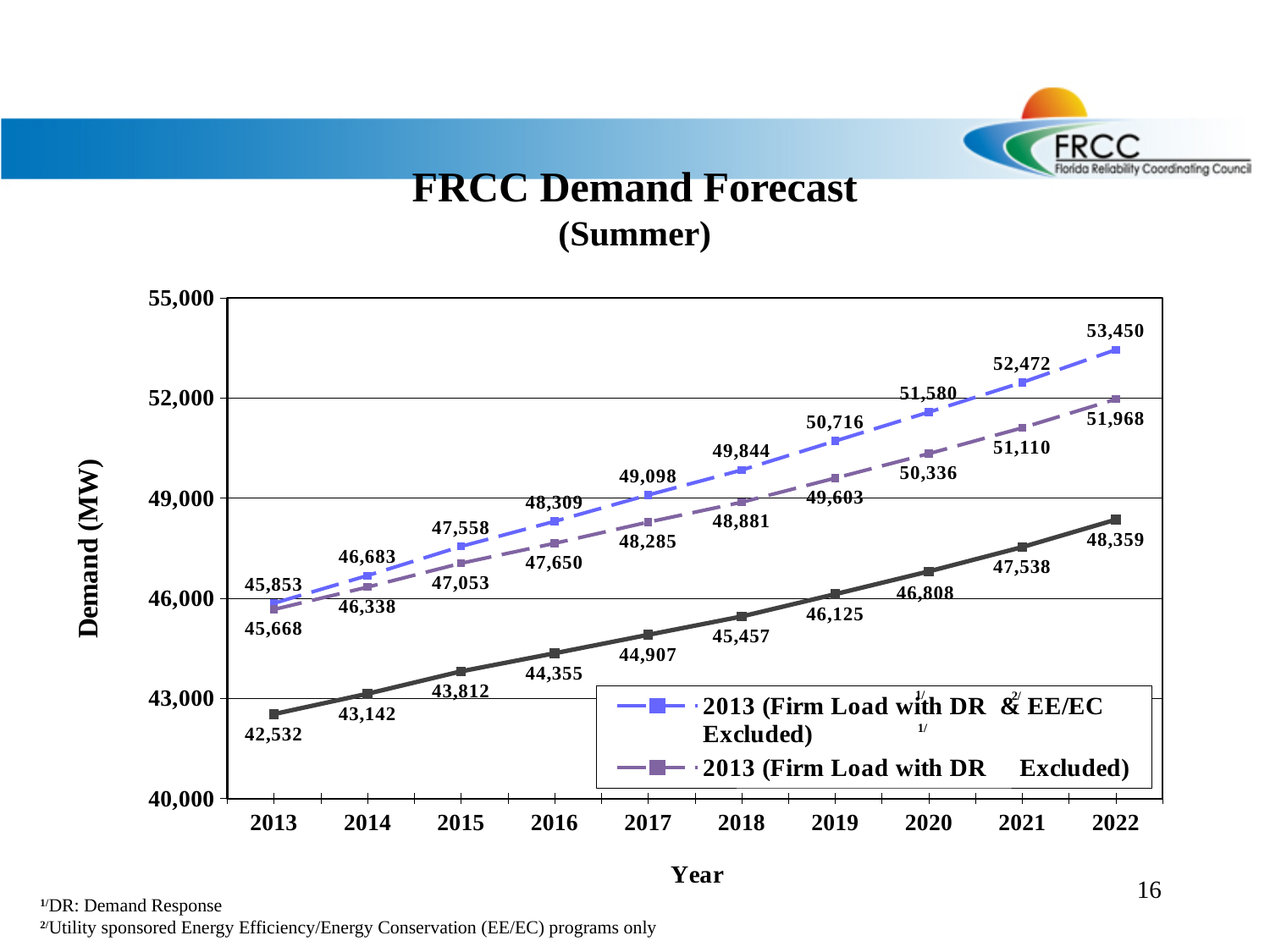
In 2018, which is larger: the '2013 (Firm Load with DR & EE/EC Excluded)' value or the '2013 (Firm Load with DR Excluded)' value? 2013 (Firm Load with DR & EE/EC Excluded) What is the difference between the two dashed series' values in 2022 (53,450 and 51,968)? 1,482 In which year is the solid black line at its lowest value? 2013 In which year does the '2013 (Firm Load with DR & EE/EC Excluded)' series reach its highest value? 2022 What is the title of the chart? FRCC Demand Forecast (Summer) Do the values of the '2013 (Firm Load with DR Excluded)' series rise or fall from 2013 to 2022? Rise How many years are plotted on the x axis? 10 What is the 2013 value for the '2013 (Firm Load with DR Excluded)' series? 45,668 What is the 2022 value for the '2013 (Firm Load with DR & EE/EC Excluded)' series? 53,450 What is the 2019 value of the solid black line? 46,125 What kind of chart is shown on the slide? Line chart How many series does the legend list? 2